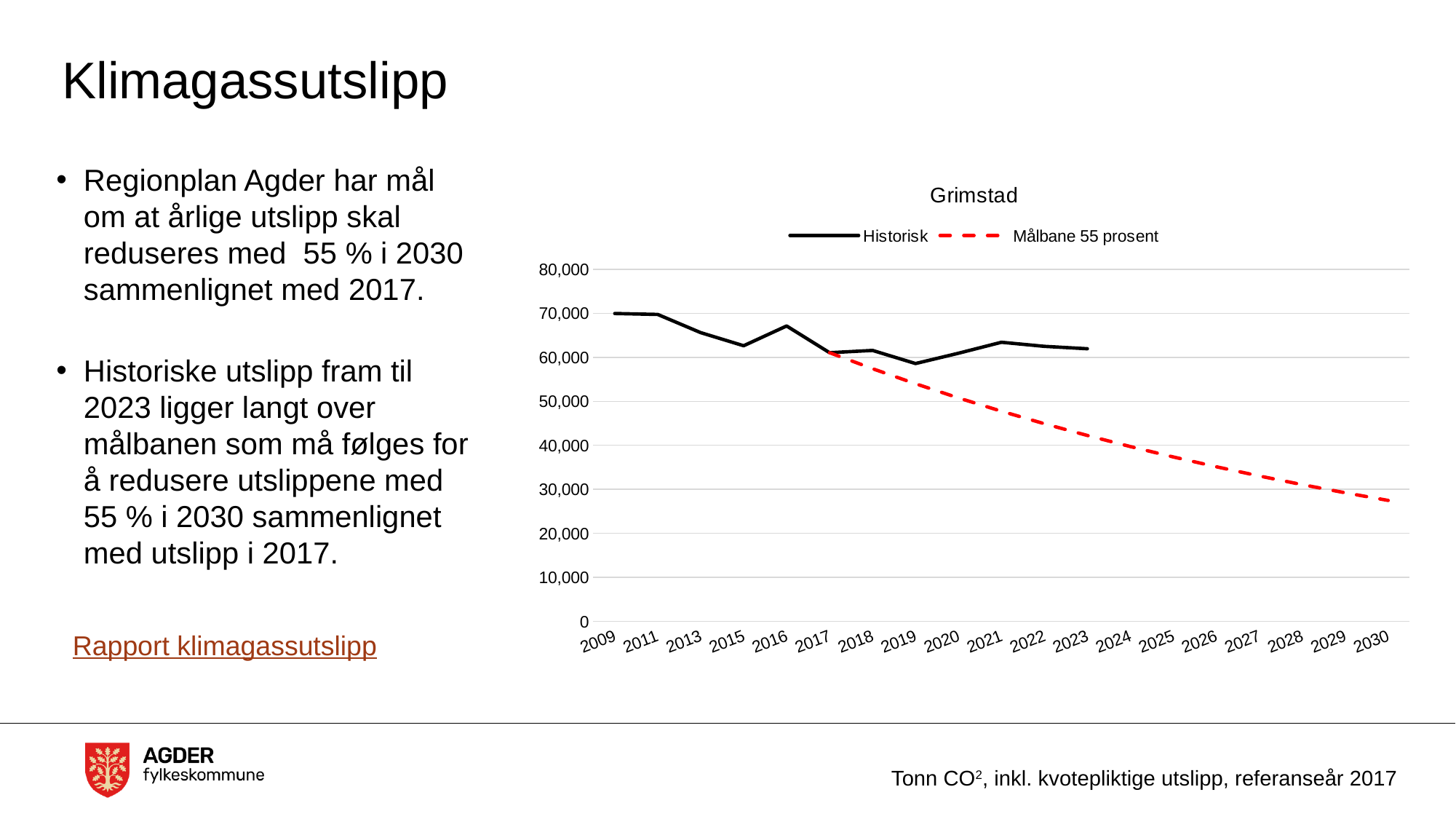
How many years are labelled on the x axis of the chart? 19 Which is larger for the Historisk series, the value for 2015 or the value for 2016? 2016 Is the Målbane 55 prosent value for 2025 greater or less than 50,000? less Does the Målbane 55 prosent series rise or fall from 2017 to 2030? fall Is the Historisk value for 2009 greater or less than 60,000? greater What is the title of the chart? Grimstad Is the Historisk value for 2016 greater or less than 60,000? greater Which series is drawn as a red dashed line? Målbane 55 prosent What kind of chart is shown on the slide? line chart How many series does the chart legend list? 2 Which is larger for the Historisk series, the value for 2009 or the value for 2023? 2009